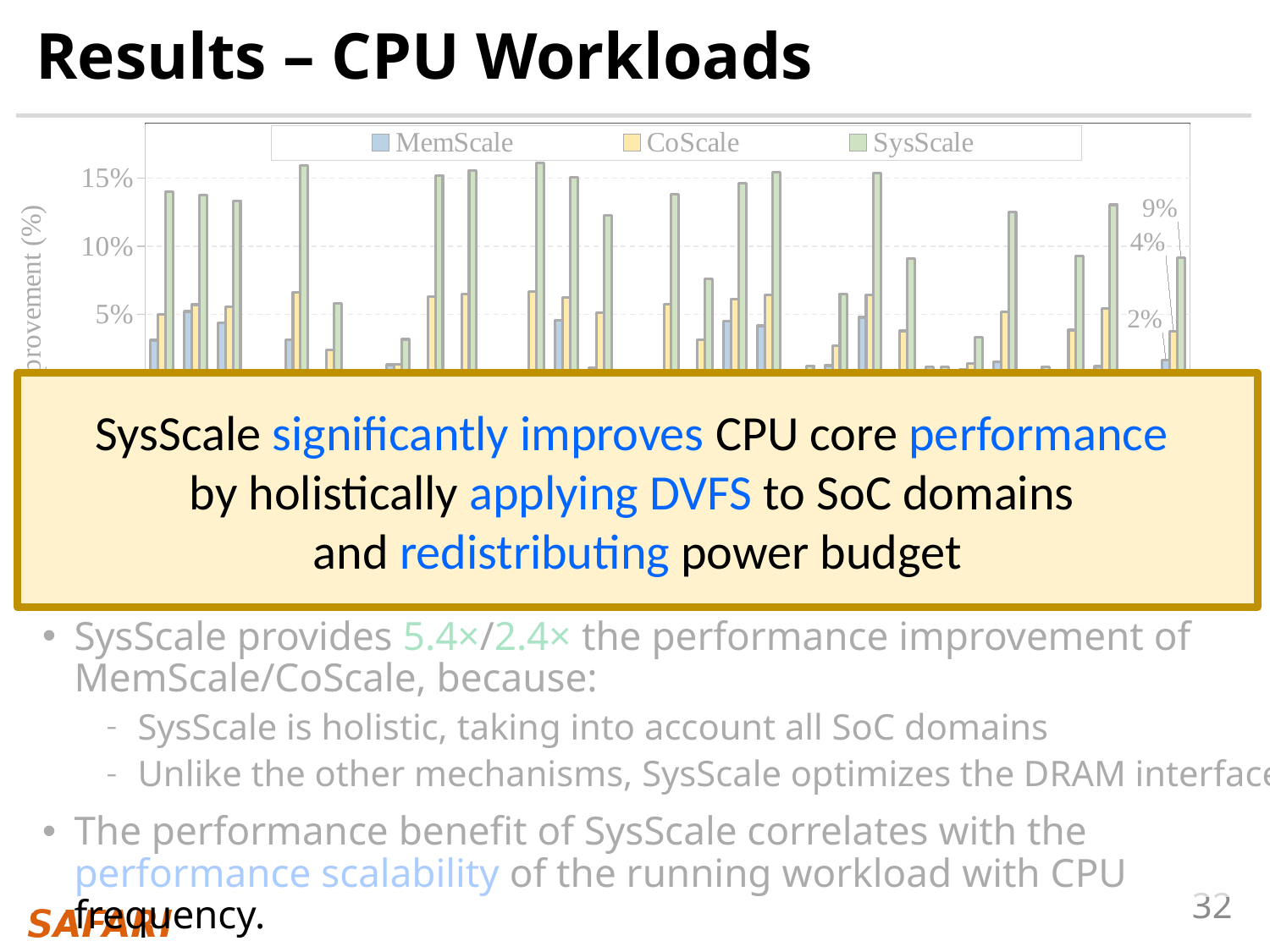
How many series does the chart legend list? 3 What is the labeled MemScale value for the rightmost group of bars? 2% Is the tallest SysScale bar in the chart greater or less than 10%? greater What is the labeled SysScale value for the rightmost group of bars? 9% What kind of chart is shown on the slide? bar chart In the rightmost group of bars, which series has the lowest labeled value? MemScale In the rightmost group of bars, what is the difference between the SysScale value and the MemScale value? 7 percentage points Which series has the tallest bars across the chart? SysScale What is the labeled CoScale value for the rightmost group of bars? 4% In the rightmost group of bars, which series has the highest labeled value? SysScale What are the three series named in the chart legend? MemScale, CoScale, SysScale In the rightmost group of bars, is the CoScale value larger or smaller than the SysScale value? smaller